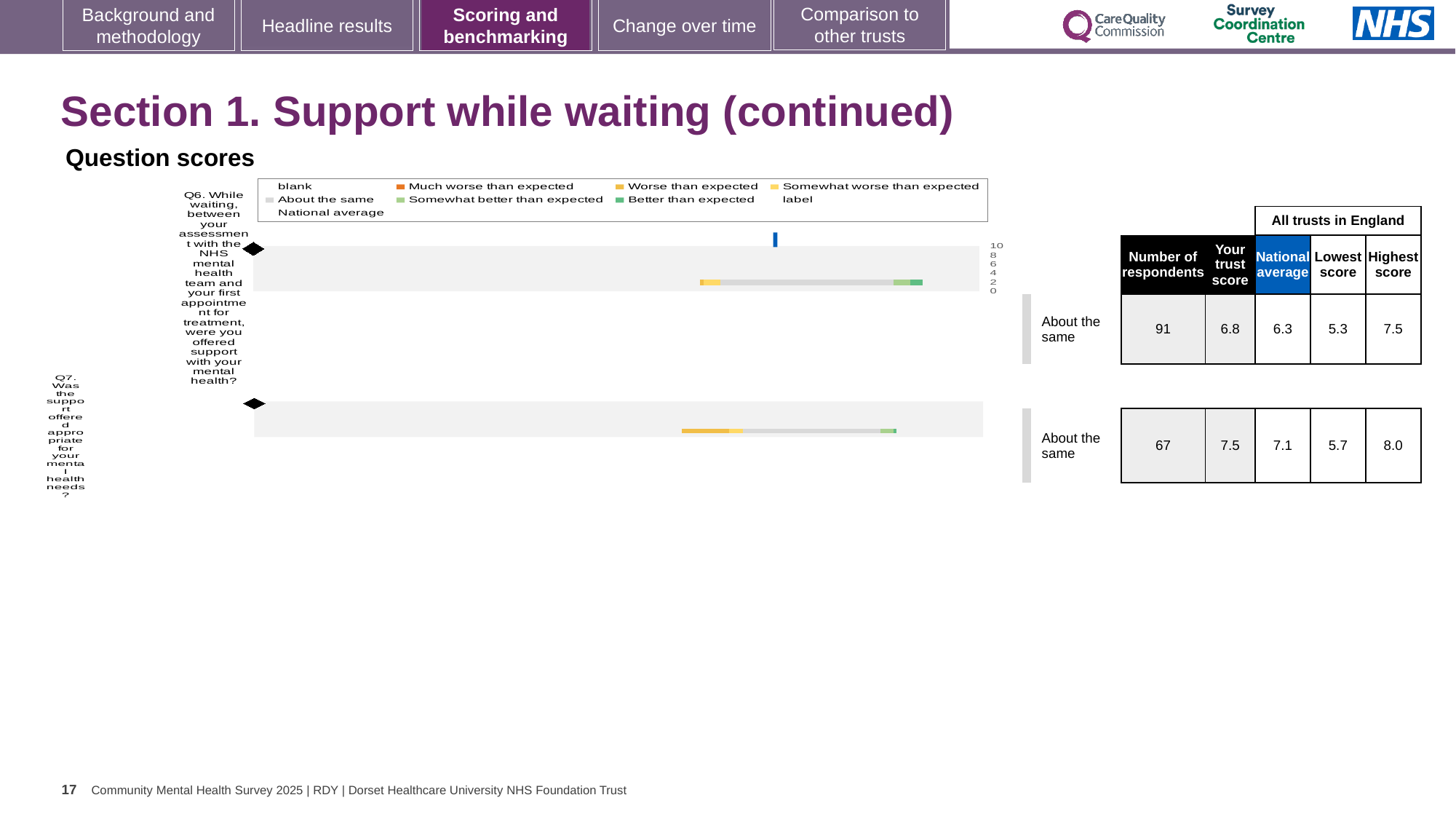
How many respondents answered Q6? 91 Which question had more respondents, Q6 or Q7? Q6 For Q7 (was the support offered appropriate for your mental health needs), what is your trust score? 7.5 For Q6, what is the difference between your trust score and the national average? 0.5 For Q7, what is the difference between the highest and lowest scores among all trusts in England? 2.3 For Q6 (support with your mental health while waiting), what is your trust score shown in the table? 6.8 For Q7, what is the lowest score among all trusts in England? 5.7 For Q6, what is the national average score? 6.3 How is your trust's Q7 score categorised relative to other trusts, according to the label next to the chart? About the same What is the maximum value shown on the score axis of the charts? 10 For Q6, which is larger: your trust score or the national average? Your trust score For Q7, what is the highest score among all trusts in England? 8.0